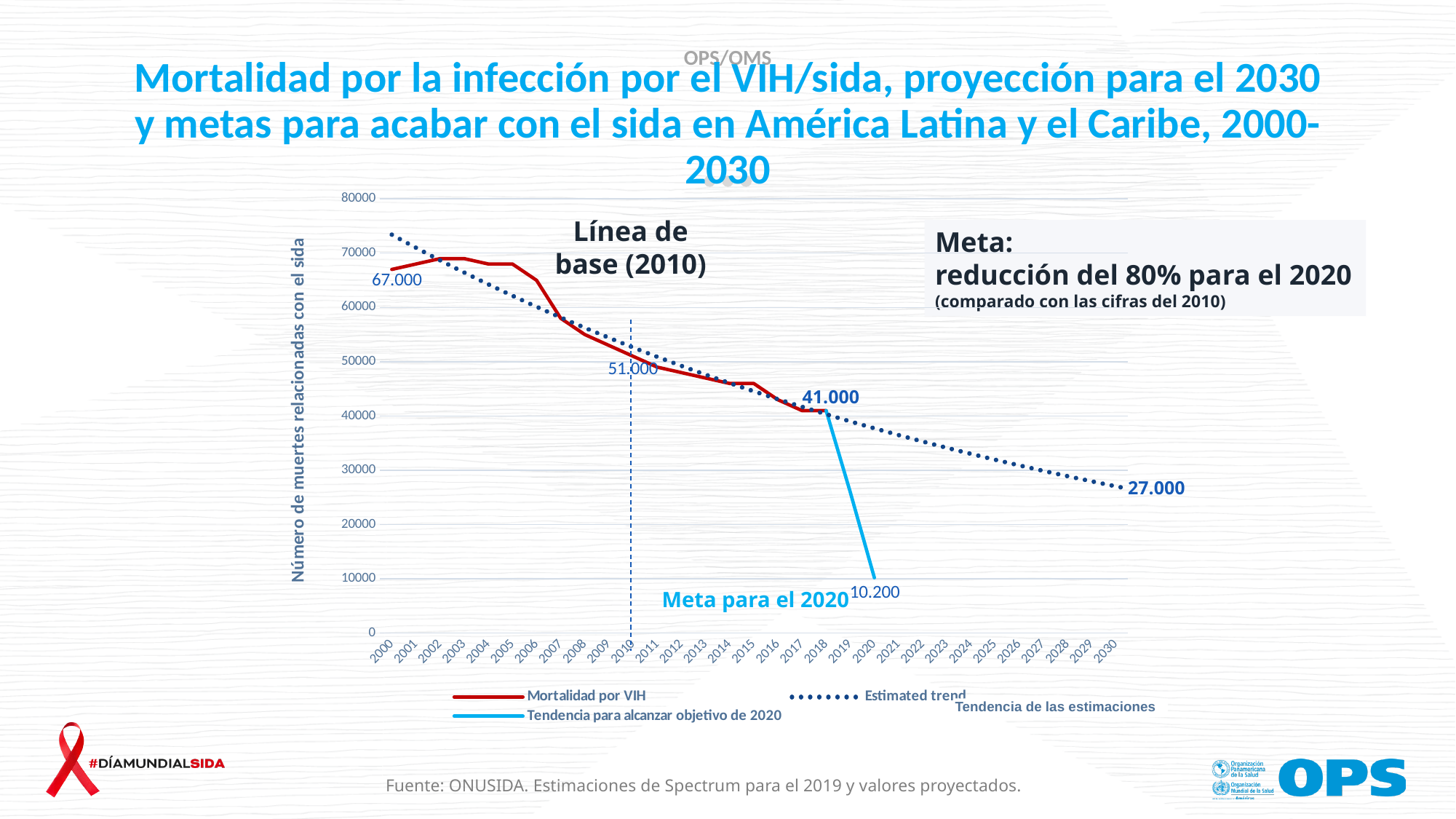
What value does the Estimated trend series reach in 2030? 27.000 Does the Mortalidad por VIH series rise or fall from 2000 to 2018? fall What is the labelled value of the Meta para el 2020 (target for 2020)? 10.200 What is the label of the vertical axis? Número de muertes relacionadas con el sida What is the difference between the labelled values for 2000 and 2018 on the Mortalidad por VIH series? 26.000 What is the labelled value at the 2010 baseline (Línea de base)? 51.000 Is the value of the Mortalidad por VIH series in 2005 greater or less than 60000? greater What is the labelled value of the Mortalidad por VIH series in 2018? 41.000 What is the difference between the 2010 baseline value and the 2020 target value? 40.800 What is the labelled value of the Mortalidad por VIH series in 2000? 67.000 What kind of chart is shown on the slide? line chart How many series does the legend list? 3